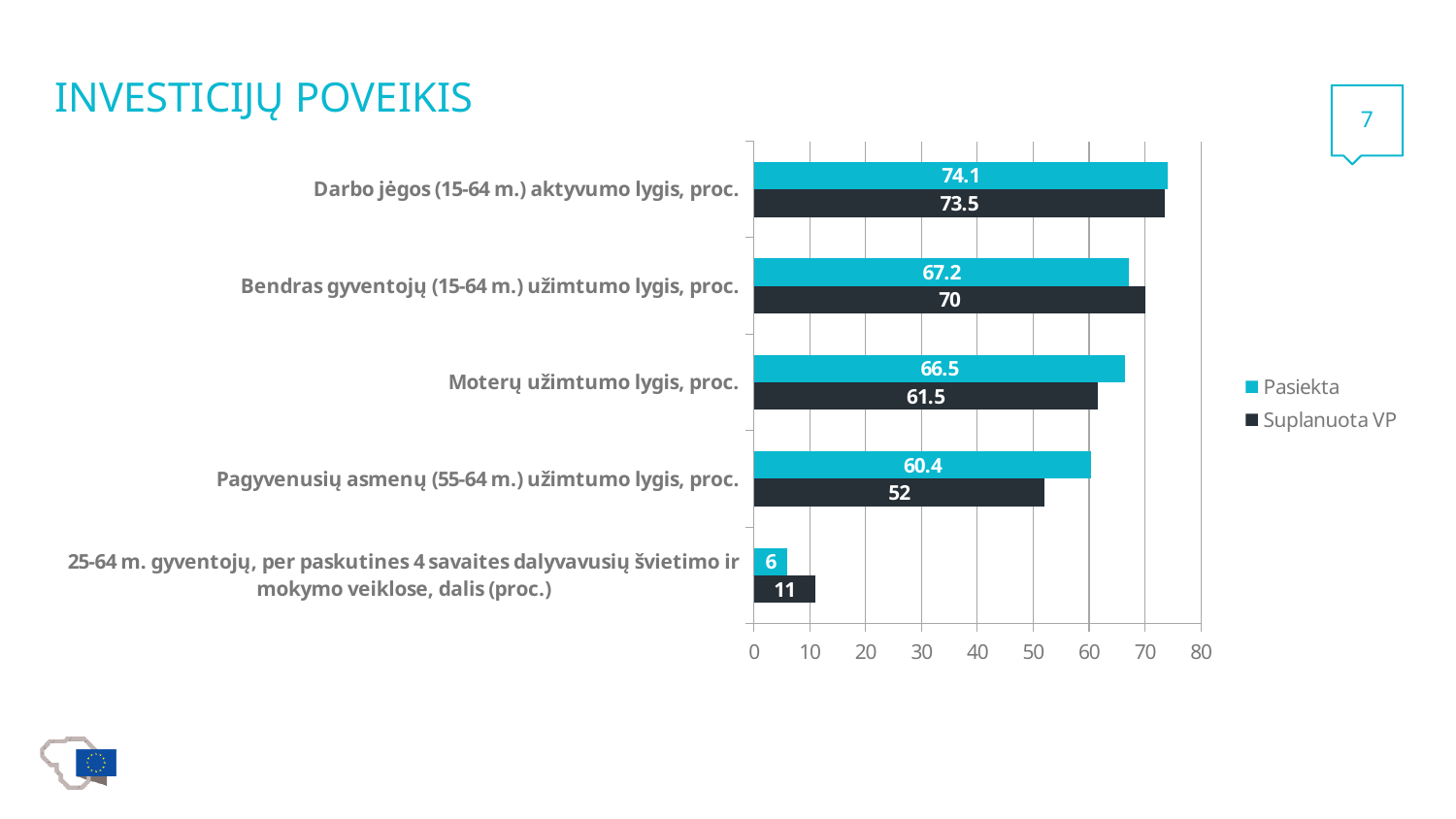
What is the Pasiekta value for Darbo jėgos (15-64 m.) aktyvumo lygis, proc.? 74.1 What is the Suplanuota VP value for Bendras gyventojų (15-64 m.) užimtumo lygis, proc.? 70 What is the Suplanuota VP value for Pagyvenusių asmenų (55-64 m.) užimtumo lygis, proc.? 52 What is the title of the slide? INVESTICIJŲ POVEIKIS What is the Pasiekta value for Moterų užimtumo lygis, proc.? 66.5 What kind of chart is shown on the slide? Bar chart For Bendras gyventojų (15-64 m.) užimtumo lygis, proc., which is larger: Pasiekta or Suplanuota VP? Suplanuota VP Which category has the highest Suplanuota VP value? Darbo jėgos (15-64 m.) aktyvumo lygis, proc. What is the difference between the Pasiekta and Suplanuota VP values for Pagyvenusių asmenų (55-64 m.) užimtumo lygis, proc.? 8.4 Which category has the lowest Pasiekta value? 25-64 m. gyventojų, per paskutines 4 savaites dalyvavusių švietimo ir mokymo veiklose, dalis (proc.) How many series does the legend list? 2 How many categories are shown on the chart? 5